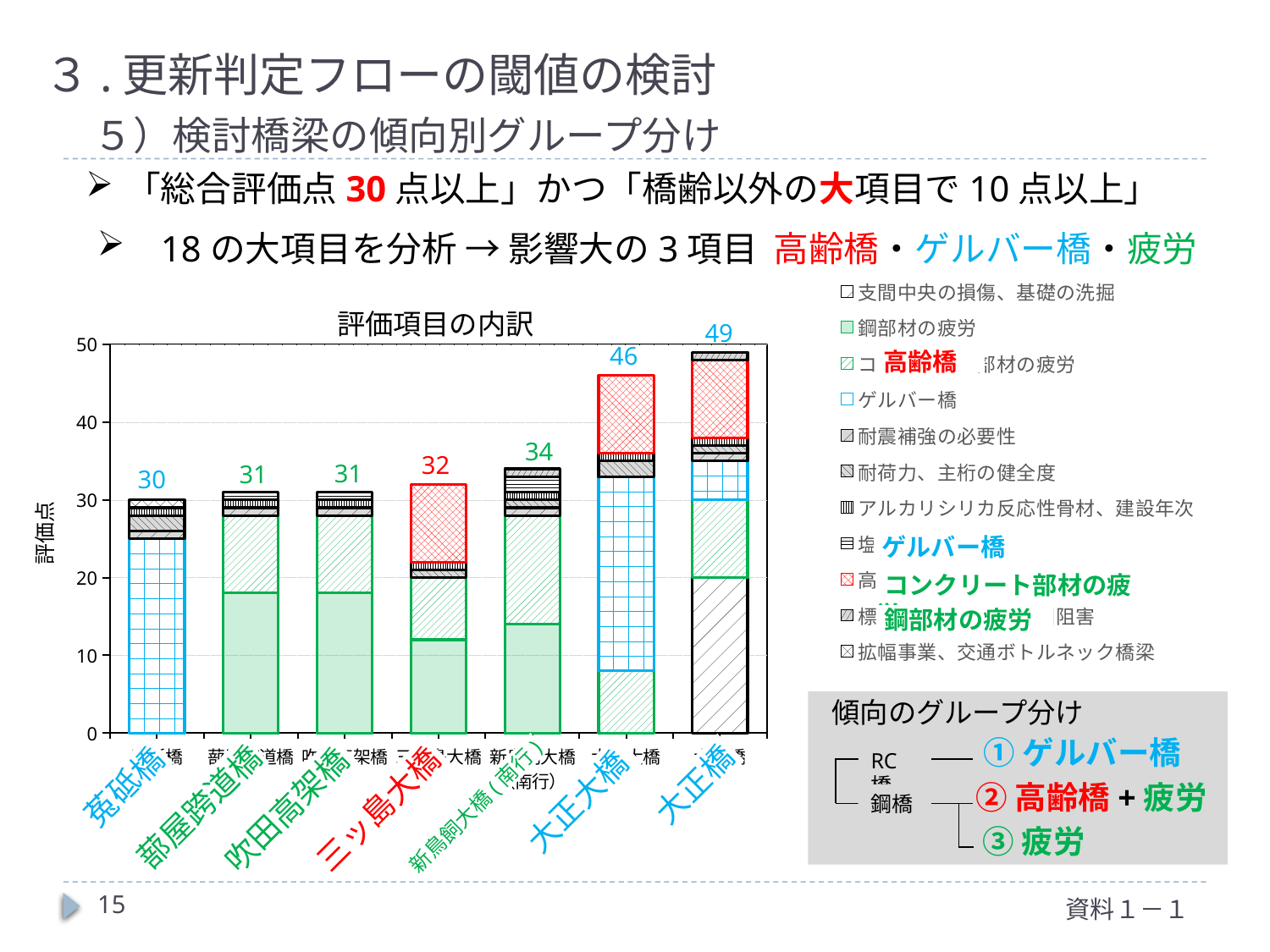
How many bridges are plotted on the x axis of the chart? 7 Do the total 評価点 values rise or fall from left to right along the x axis? rise What is the difference between the total 評価点 of 大正橋 and 菟砥橋? 19 What is the total 評価点 for 大正大橋? 46 Which bridge has the highest total 評価点 in the chart? 大正橋 Which has a higher total 評価点, 大正大橋 or 三ッ島大橋? 大正大橋 Which bridge has the lowest total 評価点 in the chart? 菟砥橋 What is the total 評価点 for 新鳥飼大橋(南行)? 34 What kind of chart is shown on the slide? stacked bar chart What is the title of the chart? 評価項目の内訳 Is the total 評価点 for 菟砥橋 greater or less than 40? less What is the total 評価点 for 三ッ島大橋? 32